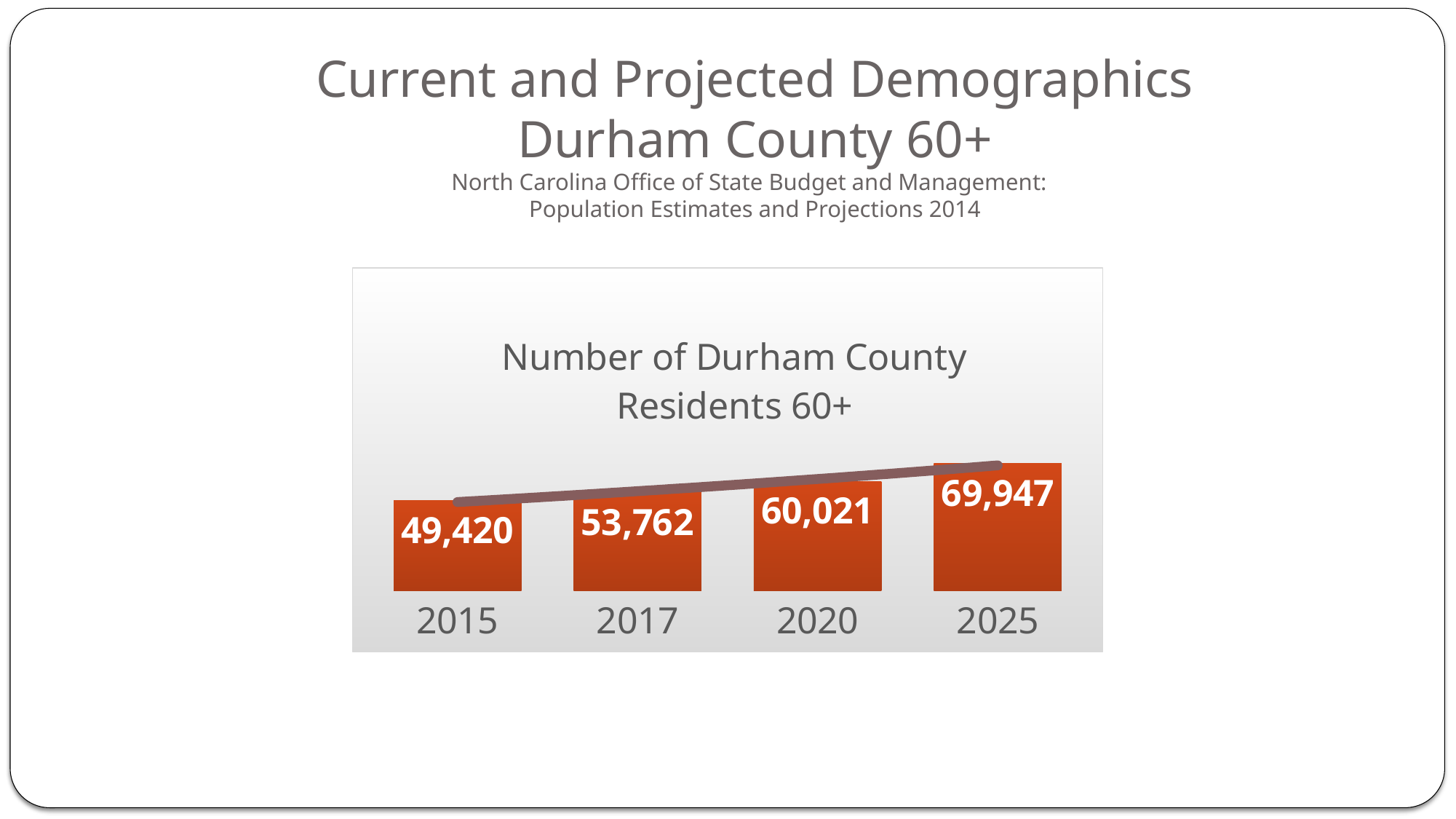
What is the number of Durham County residents 60+ in 2015? 49,420 Do the values rise or fall from 2015 to 2025? Rise Which is larger, the value for 2017 or the value for 2020? 2020 What kind of chart is shown on the slide? Bar chart Which year has the highest number of Durham County residents 60+? 2025 Which year has the lowest number of Durham County residents 60+? 2015 What is the number of Durham County residents 60+ in 2020? 60,021 What is the difference between the number of residents 60+ in 2025 and in 2015? 20,527 What is the difference between the number of residents 60+ in 2020 and in 2017? 6,259 What is the number of Durham County residents 60+ in 2017? 53,762 What is the number of Durham County residents 60+ in 2025? 69,947 How many years are shown on the chart? 4